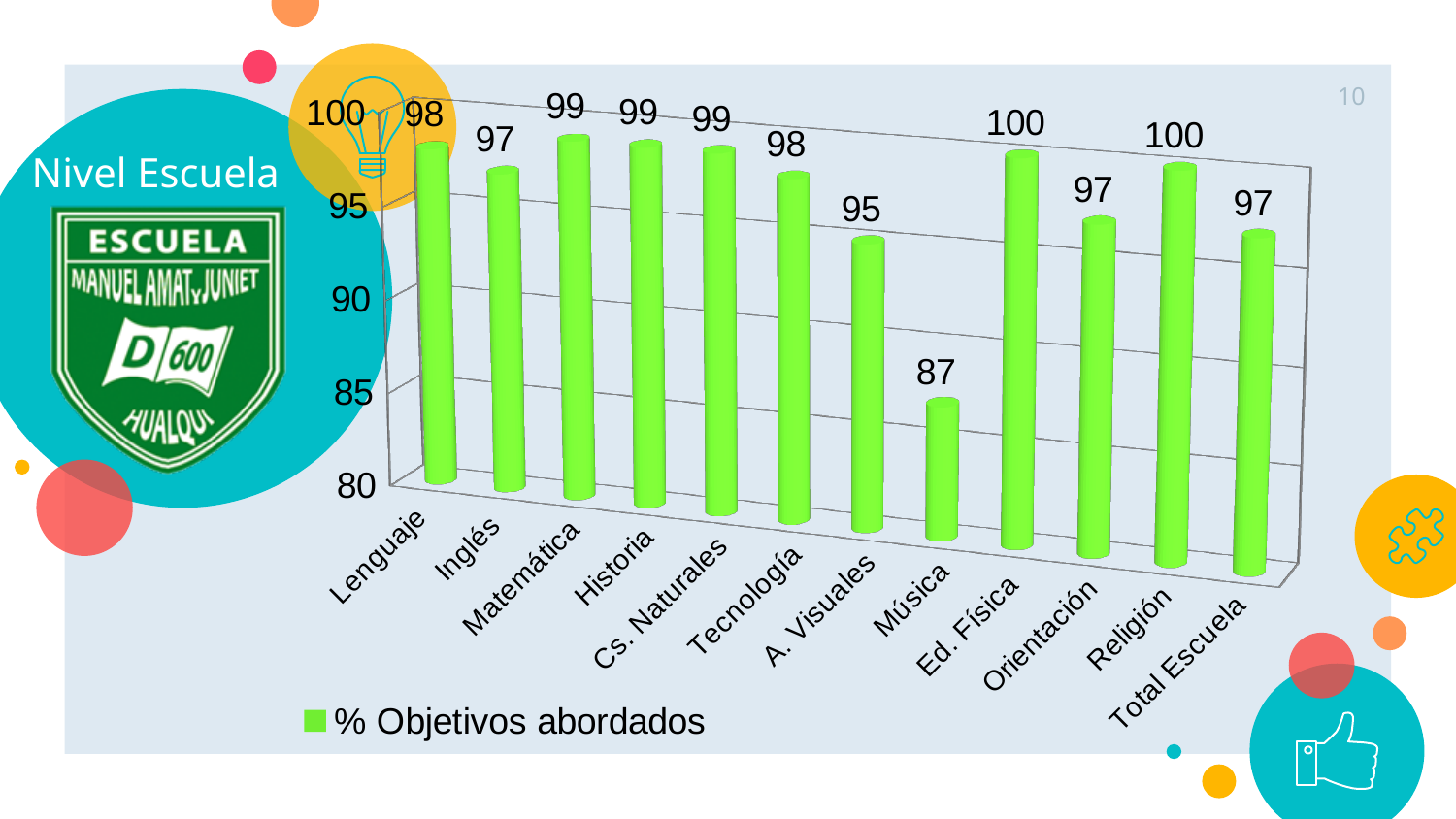
What series name does the legend show? % Objetivos abordados Which category has the lowest value? Música What is the value for Ed. Física? 100 What is the difference between the values for Ed. Física and Música? 13 What kind of chart is shown on the slide? Bar chart Which is larger, the value for Tecnología or the value for A. Visuales? Tecnología What is the highest value shown in the chart? 100 How many categories are shown on the x axis? 12 What is the value for Música? 87 What is the value for Total Escuela? 97 What is the value for A. Visuales? 95 What is the difference between the values for Matemática and Inglés? 2